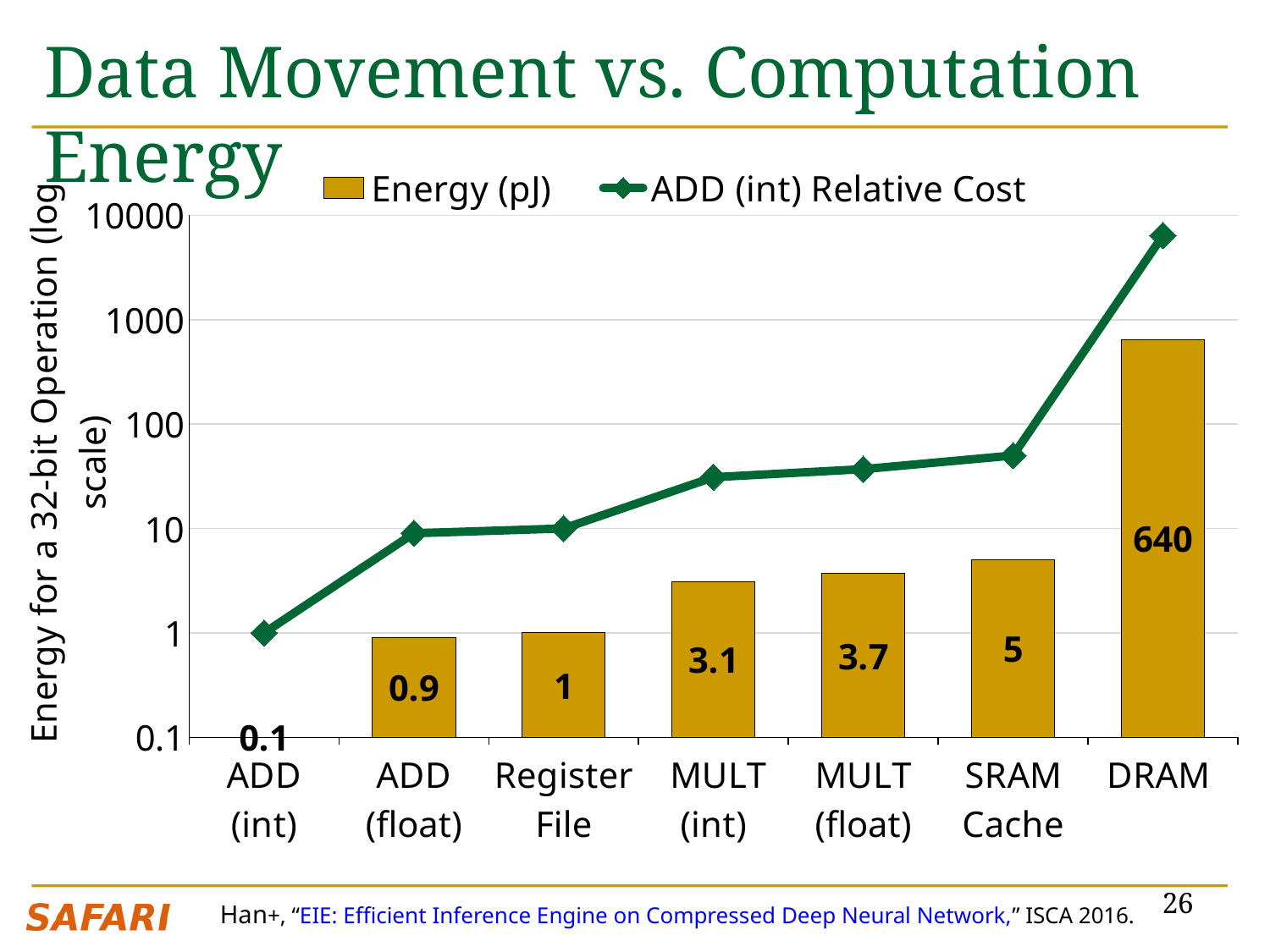
Is the ADD (int) Relative Cost value for SRAM Cache greater or less than 100? less Is the ADD (int) Relative Cost value for DRAM greater or less than 1000? greater Which has a larger Energy (pJ) value, MULT (int) or ADD (float)? MULT (int) What is the difference in Energy (pJ) between DRAM and SRAM Cache? 635 How many categories are shown on the x axis? 7 Do the Energy (pJ) values rise or fall from ADD (int) to DRAM along the x axis? rise Which category has the lowest Energy (pJ) value? ADD (int) What is the Energy (pJ) value for SRAM Cache? 5 How many series does the legend list? 2 What is the Energy (pJ) value for MULT (float)? 3.7 What is the Energy (pJ) value for DRAM? 640 Which category has the highest Energy (pJ) value? DRAM